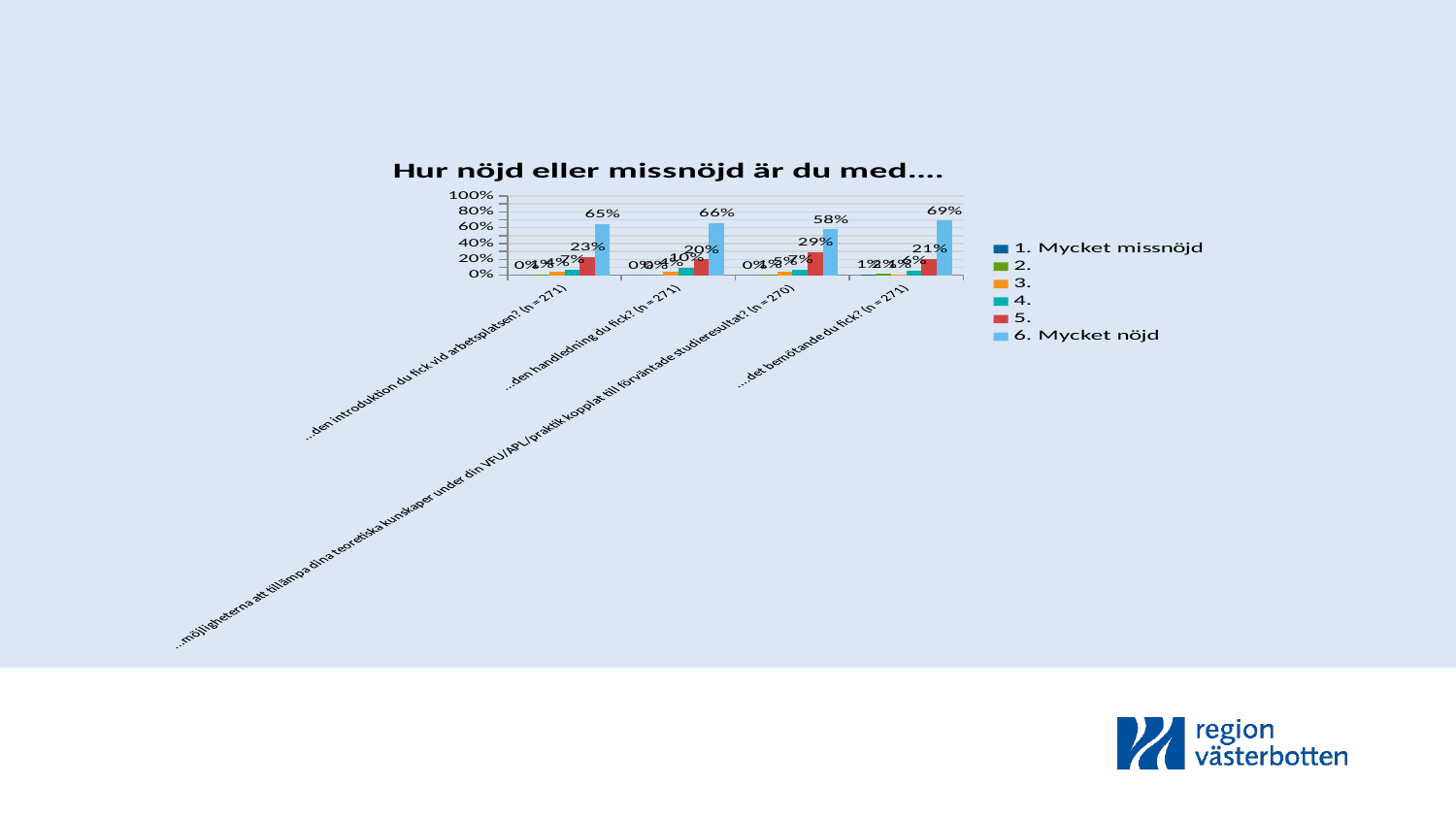
What is the difference between the '6. Mycket nöjd' values for '...det bemötande du fick? (n=271)' and '...den introduktion du fick vid arbetsplatsen? (n=271)'? 4% What is the value of '6. Mycket nöjd' for '...det bemötande du fick? (n=271)'? 69% What kind of chart is shown on the slide? bar chart Which is larger for '...den handledning du fick? (n=271)': the value for '5.' or the value for '6. Mycket nöjd'? 6. Mycket nöjd What is the value of '5.' for the category about '...möjligheterna att tillämpa dina teoretiska kunskaper... (n=270)'? 29% Which category has the highest value for '6. Mycket nöjd'? ...det bemötande du fick? (n=271) How many categories are shown on the x axis? 4 What is the value of '6. Mycket nöjd' for '...den introduktion du fick vid arbetsplatsen? (n=271)'? 65% What is the title of the chart? Hur nöjd eller missnöjd är du med.... Which category has the lowest value for '6. Mycket nöjd'? ...möjligheterna att tillämpa dina teoretiska kunskaper under din VFU/APL/praktik kopplat till förväntade studieresultat? (n=270) How many series does the legend list? 6 What is the value of '5.' for '...den handledning du fick? (n=271)'? 20%